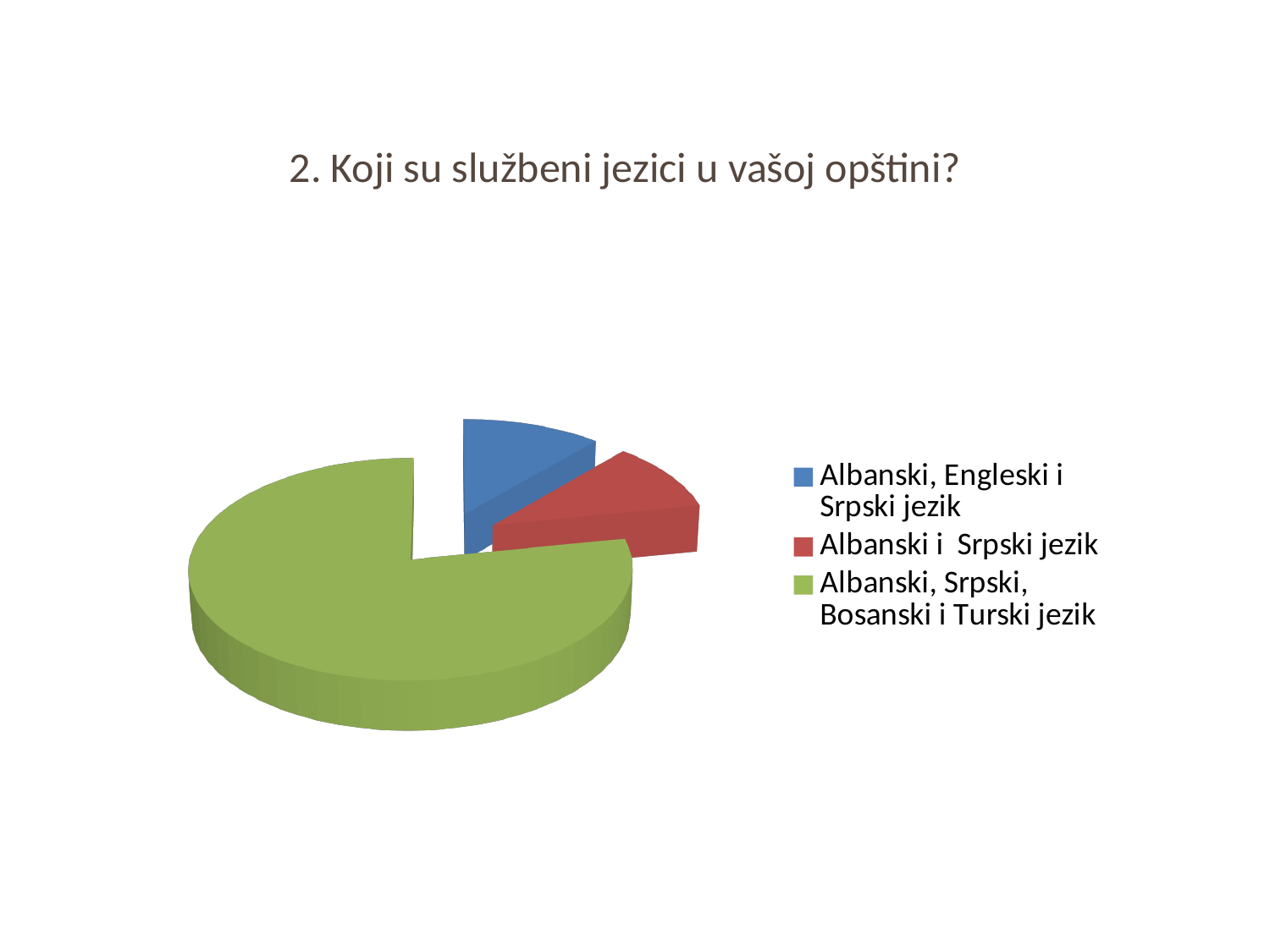
What colour is the slice for "Albanski i Srpski jezik"? Red What is the title of the chart on the slide? 2. Koji su službeni jezici u vašoj opštini? How many entries does the legend of the pie chart list? 3 Which category has the largest slice of the pie chart? Albanski, Srpski, Bosanski i Turski jezik Which slice is larger: "Albanski, Engleski i Srpski jezik" or "Albanski, Srpski, Bosanski i Turski jezik"? Albanski, Srpski, Bosanski i Turski jezik How many slices does the pie chart have? 3 Which slice is larger: "Albanski i Srpski jezik" or "Albanski, Srpski, Bosanski i Turski jezik"? Albanski, Srpski, Bosanski i Turski jezik What kind of chart is shown on the slide? Pie chart